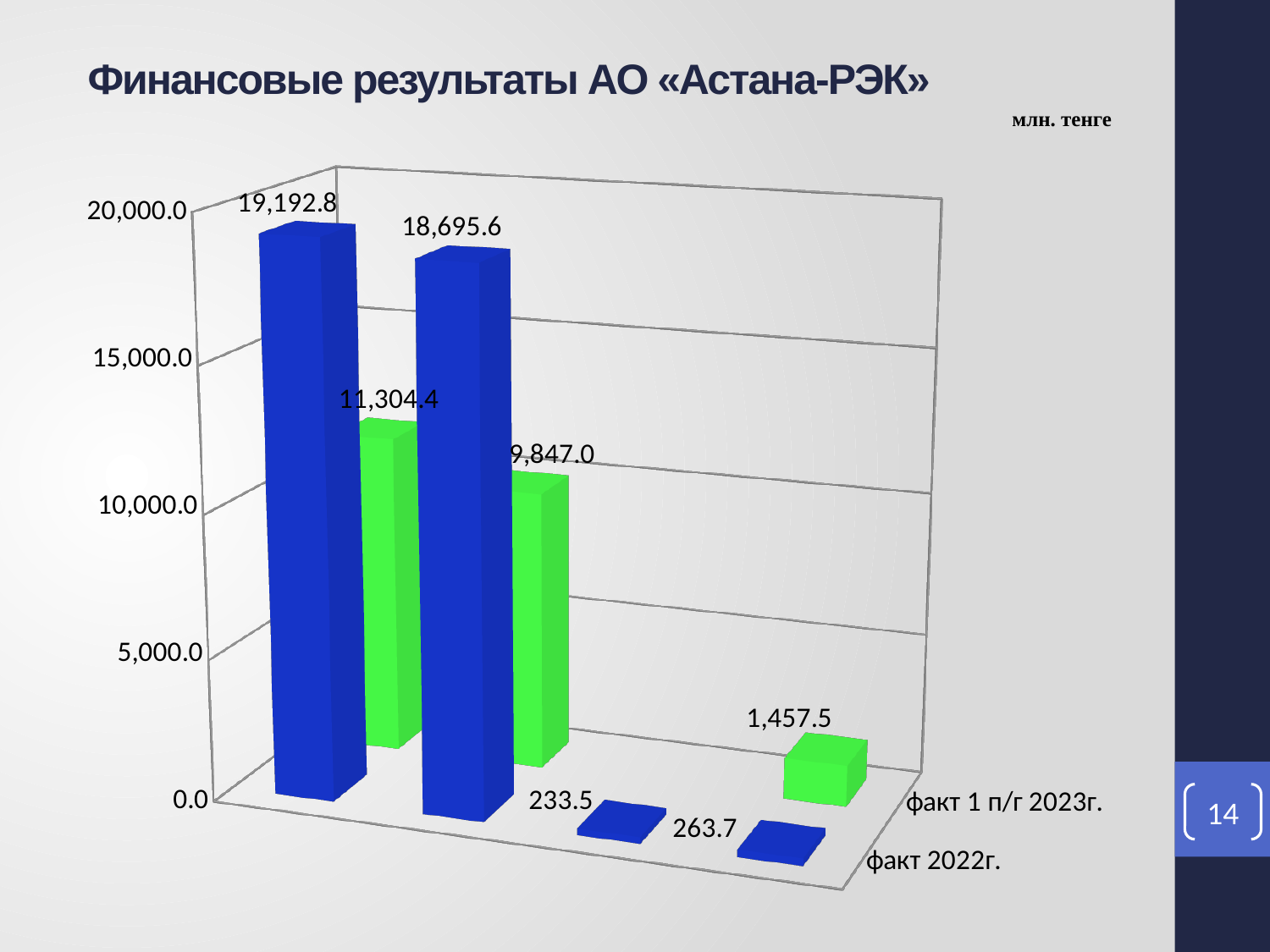
What is the lowest value in the series "факт 1 п/г 2023г."? 1,457.5 What is the highest value in the series "факт 2022г."? 19,192.8 Which is larger: the first bar of "факт 2022г." (19,192.8) or the first bar of "факт 1 п/г 2023г." (11,304.4)? факт 2022г. (19,192.8) How many data series are plotted on the chart? 2 What is the lowest value in the series "факт 2022г."? 233.5 What kind of chart is shown on the slide? bar chart How many bars are plotted for the series "факт 2022г."? 4 In what unit are the values on the chart expressed? млн. тенге What is the difference between the two largest values in the series "факт 2022г." (19,192.8 and 18,695.6)? 497.2 What is the difference between the two largest values in the series "факт 1 п/г 2023г." (11,304.4 and 9,847.0)? 1,457.4 What is the title of the chart on the slide? Финансовые результаты АО «Астана-РЭК» What is the highest value in the series "факт 1 п/г 2023г."? 11,304.4